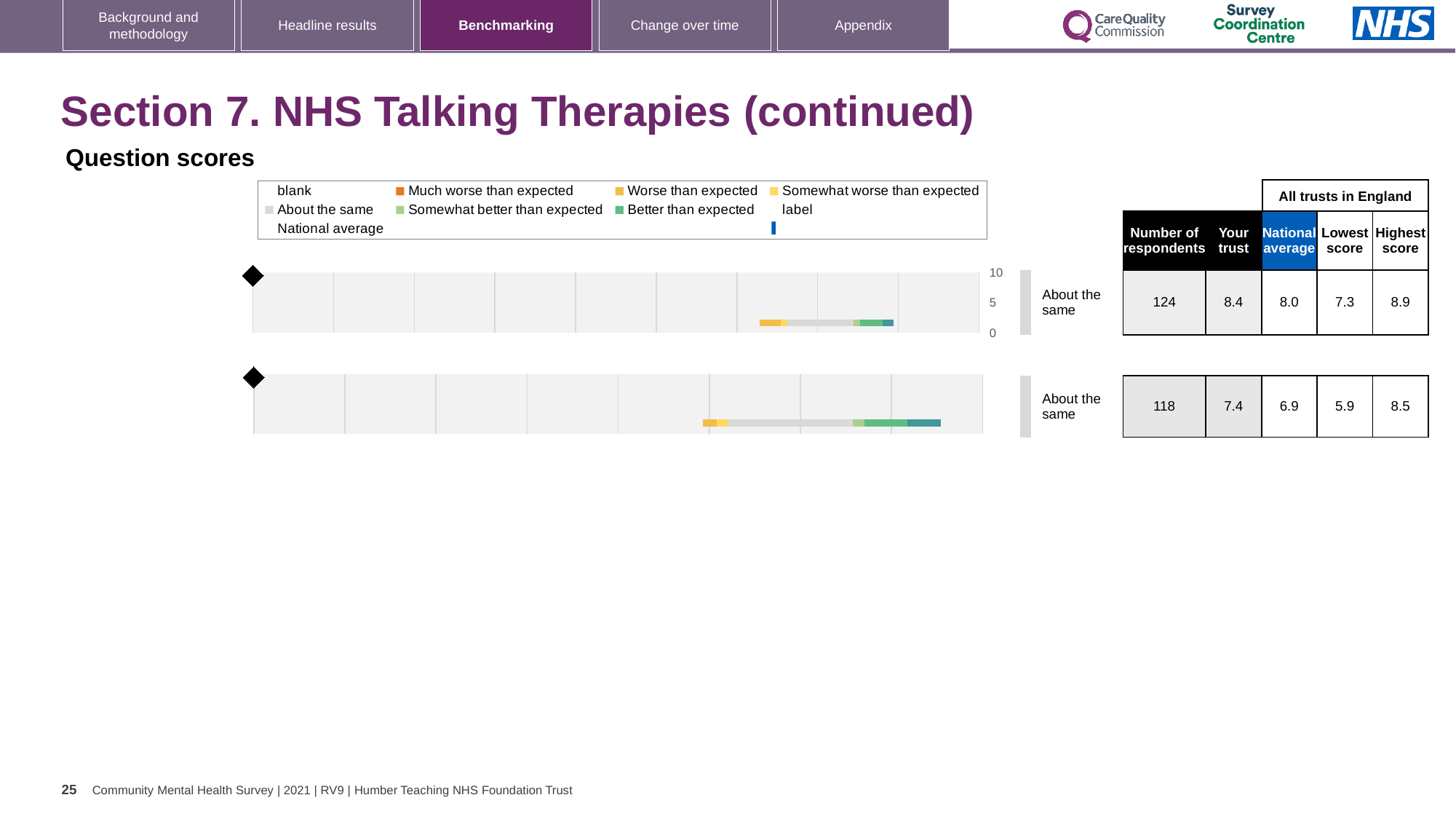
What benchmark category is shown beside both the top and bottom charts? About the same For the bottom chart's question, what is the difference between the 'Your trust' score and the national average? 0.5 In the table next to the top chart, what is the highest score among all trusts in England? 8.9 How many respondents are listed for the top chart's question? 124 For the top chart's question, how much higher is the 'Your trust' score than the national average? 0.4 In the table next to the bottom chart, what is the 'Your trust' score? 7.4 What is the maximum value shown on the vertical axis of the top chart? 10 In the table next to the bottom chart, what is the lowest score among all trusts in England? 5.9 In the table next to the top chart, what is the 'Your trust' score? 8.4 In the table next to the bottom chart, what is the national average score? 6.9 Which chart's question has the higher 'Your trust' score, the top chart or the bottom chart? top chart In the table next to the top chart, what is the national average score? 8.0